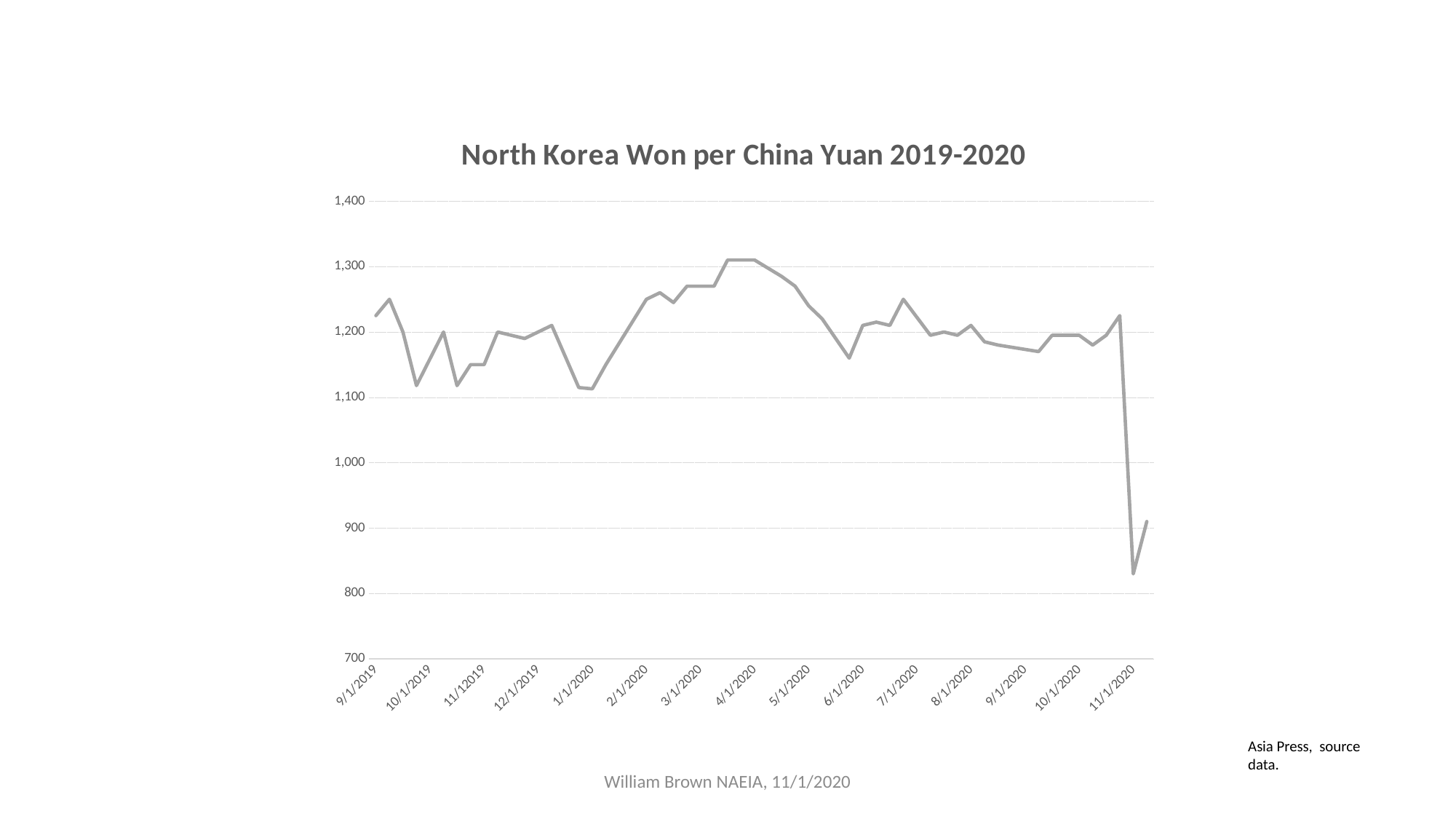
What is the title of the chart? North Korea Won per China Yuan 2019-2020 Is the value at 1/1/2020 greater or less than 1,200? less Around which x-axis date does the line reach its highest value? 4/1/2020 Is the value at 9/1/2019 greater or less than 1,200? greater What is the highest value shown on the y axis? 1,400 Is the lowest point of the line, just after 11/1/2020, greater or less than 900? less Does the line rise or fall between 1/1/2020 and 4/1/2020? rise What kind of chart is shown on the slide? line chart Does the line rise or fall between 4/1/2020 and 6/1/2020? fall How many date labels are shown along the x axis? 15